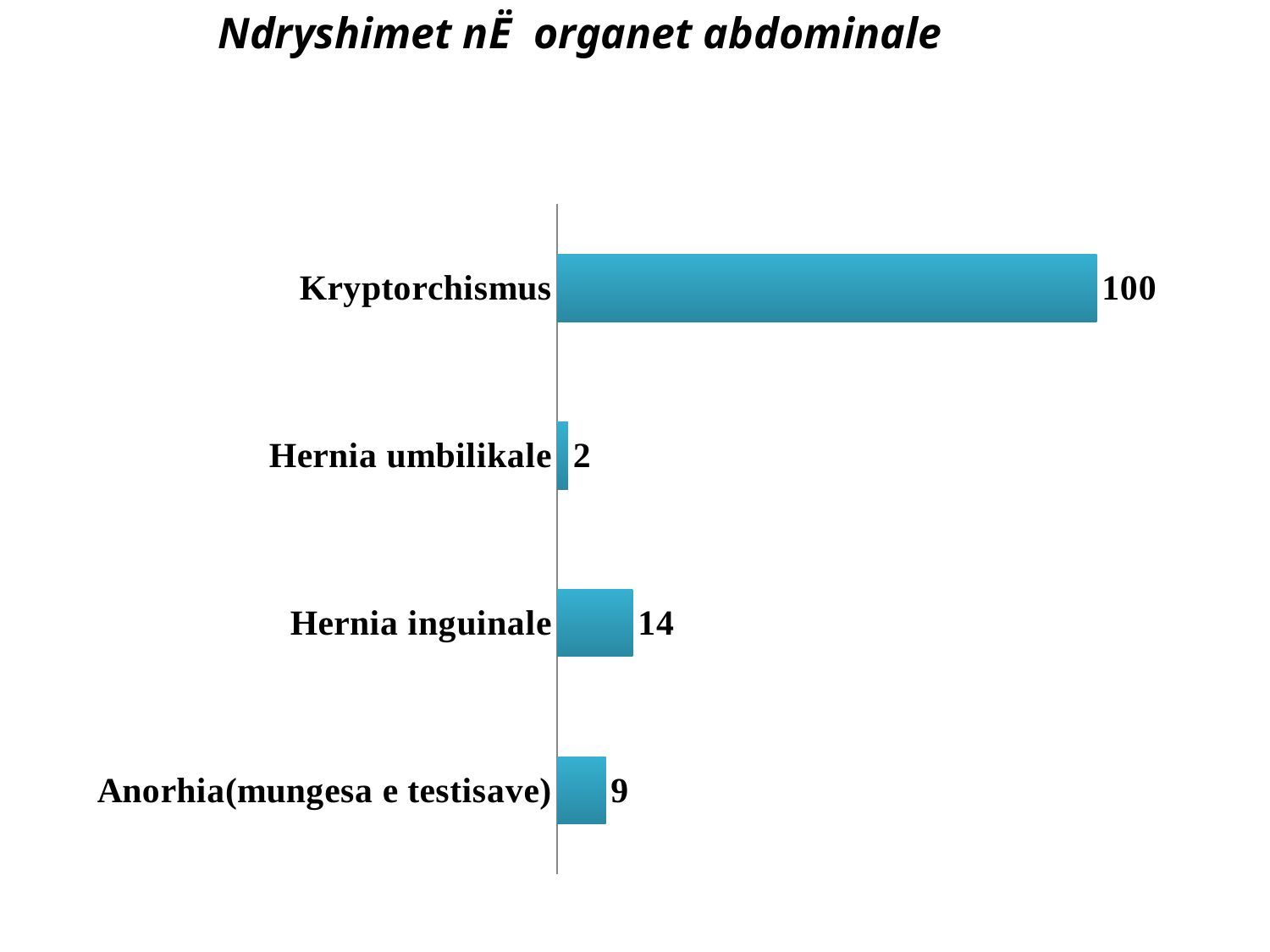
How many categories are shown in the chart? 4 What is the value for Anorhia(mungesa e testisave)? 9 What is the value for Hernia inguinale? 14 What kind of chart is shown on the slide? Bar chart Which category has the highest value? Kryptorchismus Which is larger, the value for Hernia inguinale or the value for Anorhia(mungesa e testisave)? Hernia inguinale What is the value for Kryptorchismus? 100 What is the value for Hernia umbilikale? 2 What is the difference between the values for Hernia inguinale and Anorhia(mungesa e testisave)? 5 Which category has the lowest value? Hernia umbilikale What is the difference between the values for Kryptorchismus and Hernia inguinale? 86 What is the title of the chart? Ndryshimet nË organet abdominale